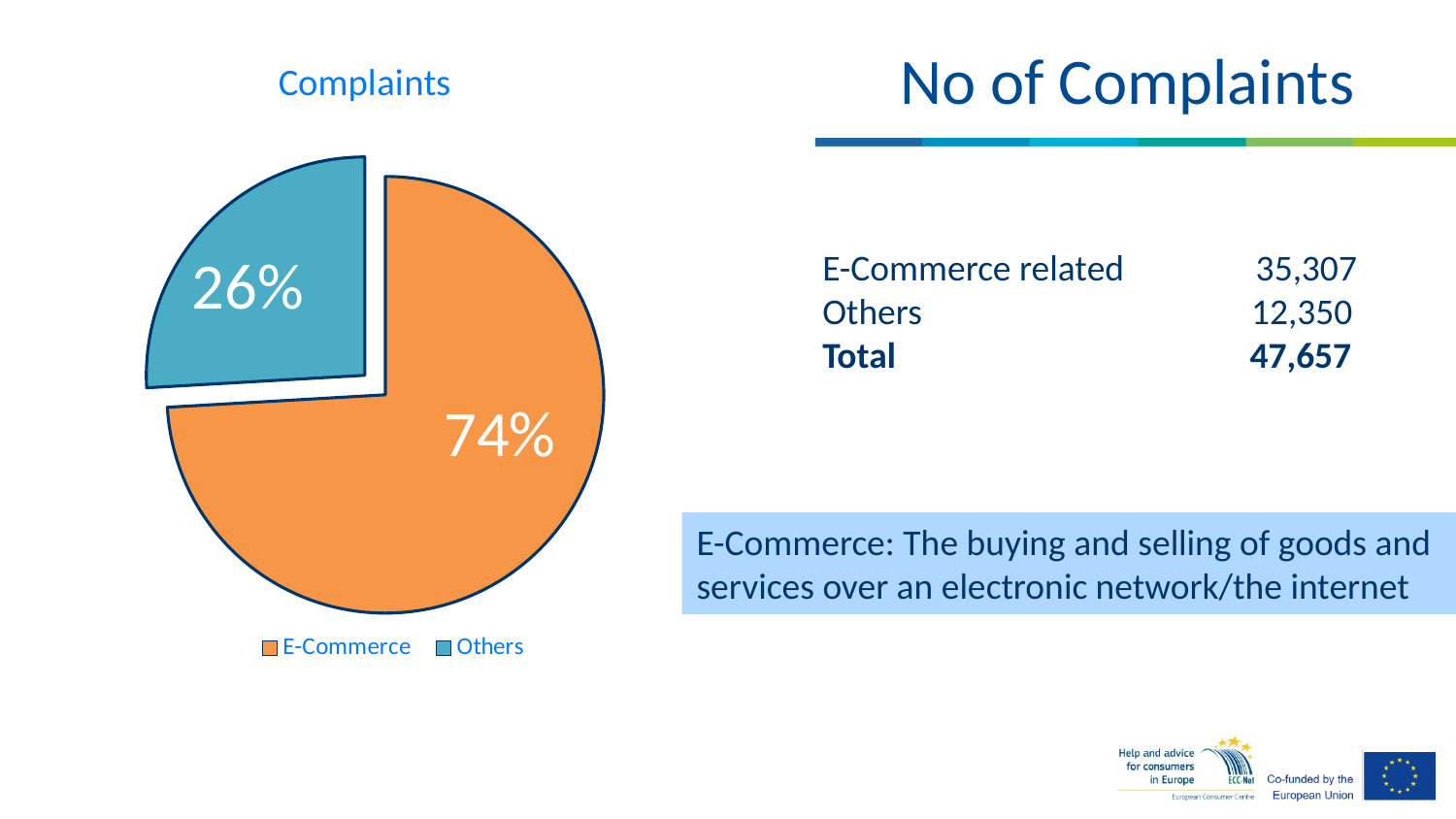
What colour is the E-Commerce slice in the pie chart? Orange How many entries does the legend list? 2 Is the share for Others greater or less than 50%? less Which is larger, the E-Commerce slice or the Others slice? E-Commerce What share of the pie does the Others slice represent? 26% What kind of chart is shown on the slide? Pie chart What share of the pie does the E-Commerce slice represent? 74% How many slices does the pie chart have? 2 What is the difference in percentage points between the E-Commerce slice and the Others slice? 48 percentage points Which slice of the pie is the smallest? Others What is the title of the chart? Complaints Which slice of the pie is the largest? E-Commerce